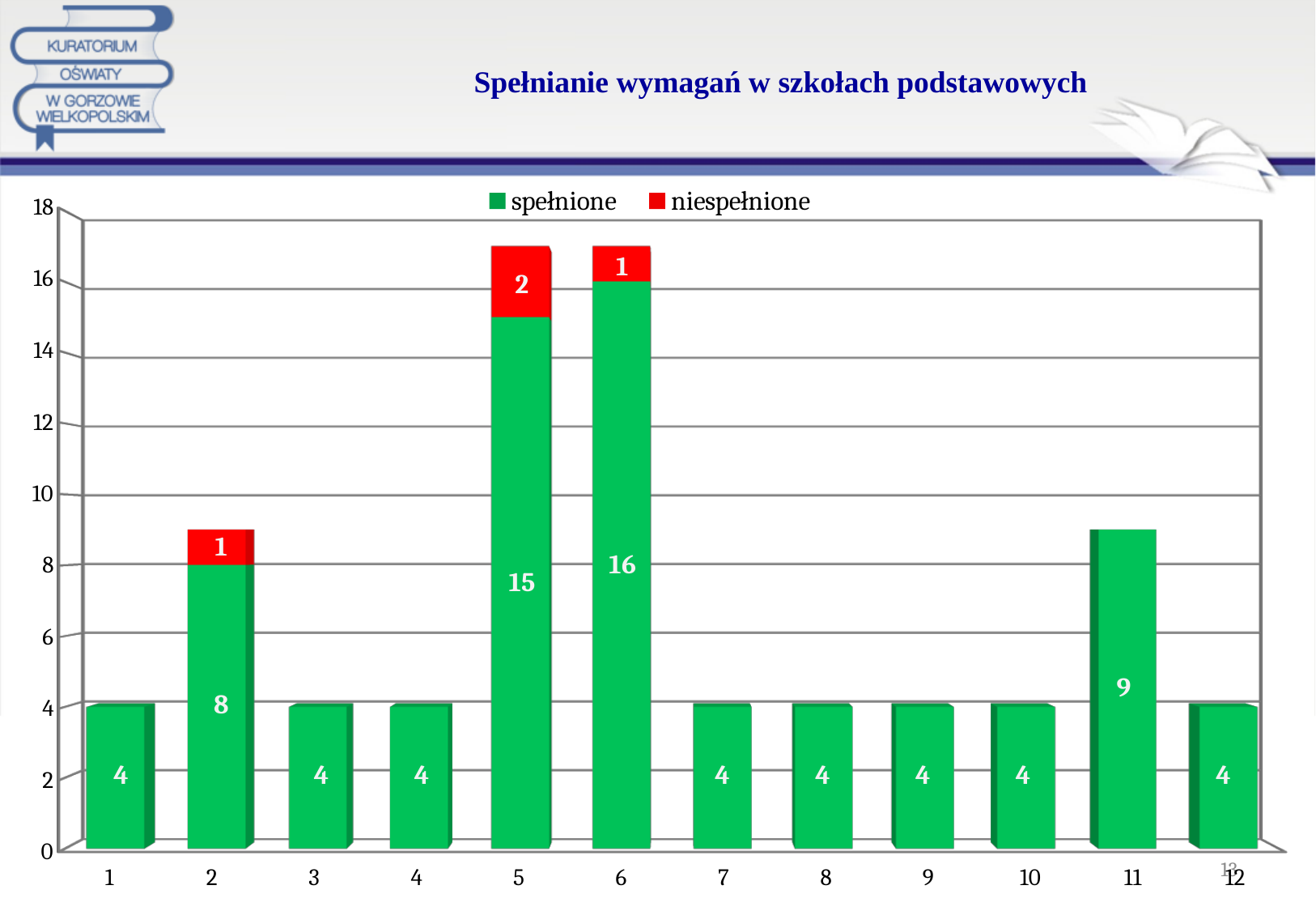
How many categories are shown on the x axis? 12 What kind of chart is shown on the slide? stacked bar chart What is the value of spełnione for category 6? 16 What is the total of the stacked bar for category 2? 9 What is the value of spełnione for category 11? 9 What is the total of the stacked bar for category 5? 17 What is the difference between the spełnione values for category 6 and category 5? 1 Which is larger, the spełnione value for category 11 or for category 2? category 11 What is the value of niespełnione for category 5? 2 How many series does the legend list? 2 Which category has the highest niespełnione value? 5 Which category has the highest spełnione value? 6